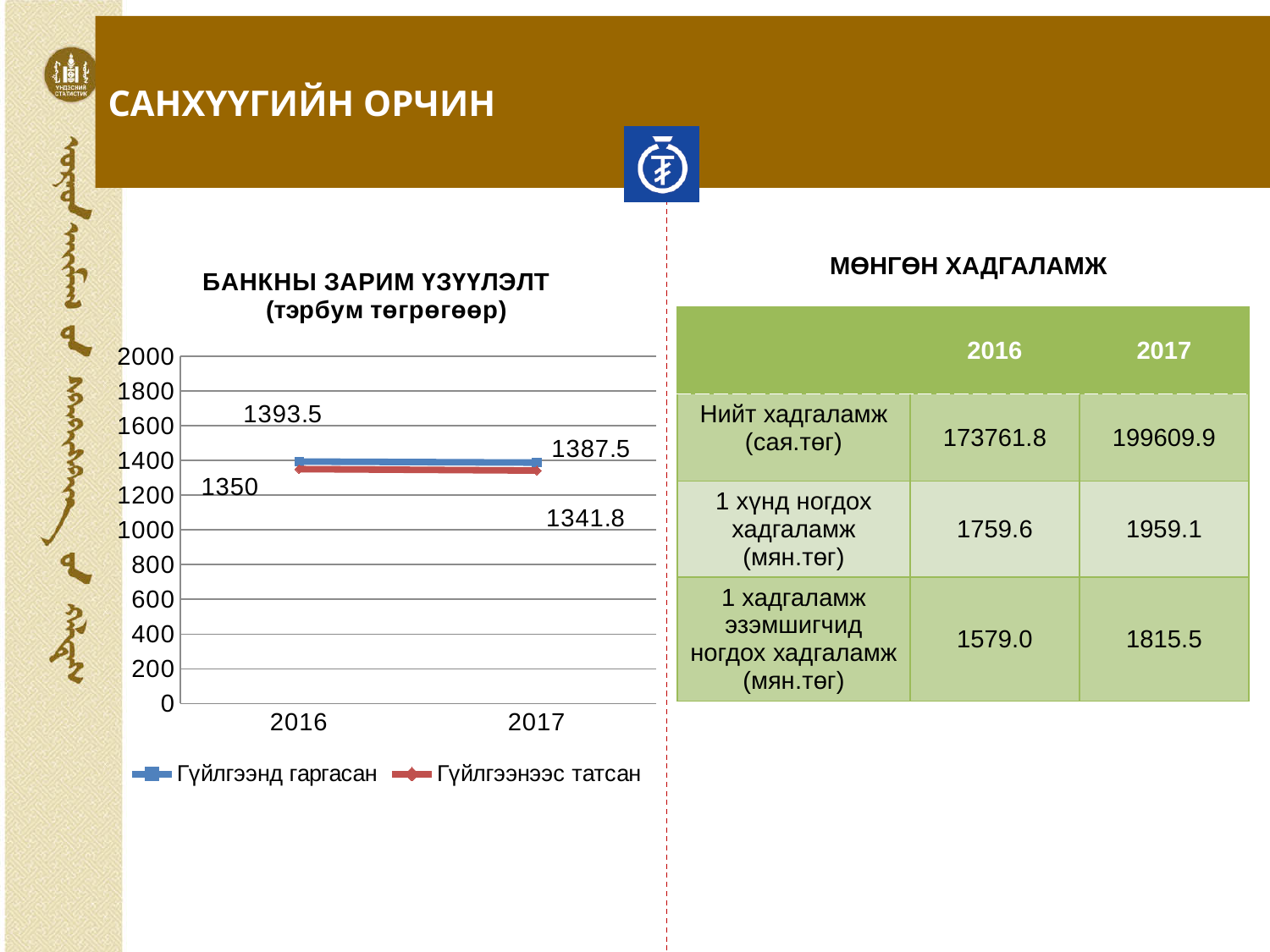
What is the difference between Гүйлгээнд гаргасан and Гүйлгээнээс татсан in 2016? 43.5 What is the title of the chart? БАНКНЫ ЗАРИМ ҮЗҮҮЛЭЛТ (тэрбум төгрөгөөр) What is the value for Гүйлгээнээс татсан in 2016? 1350 What is the value for Гүйлгээнд гаргасан in 2017? 1387.5 Does the value for Гүйлгээнээс татсан rise or fall from 2016 to 2017? fall What is the value for Гүйлгээнээс татсан in 2017? 1341.8 Which series has the higher value in 2017, Гүйлгээнд гаргасан or Гүйлгээнээс татсан? Гүйлгээнд гаргасан How many years are shown on the x axis of the chart? 2 How many series does the chart legend list? 2 What kind of chart is shown on the slide? line chart What is the value for Гүйлгээнд гаргасан in 2016? 1393.5 What is the difference between Гүйлгээнд гаргасан and Гүйлгээнээс татсан in 2017? 45.7